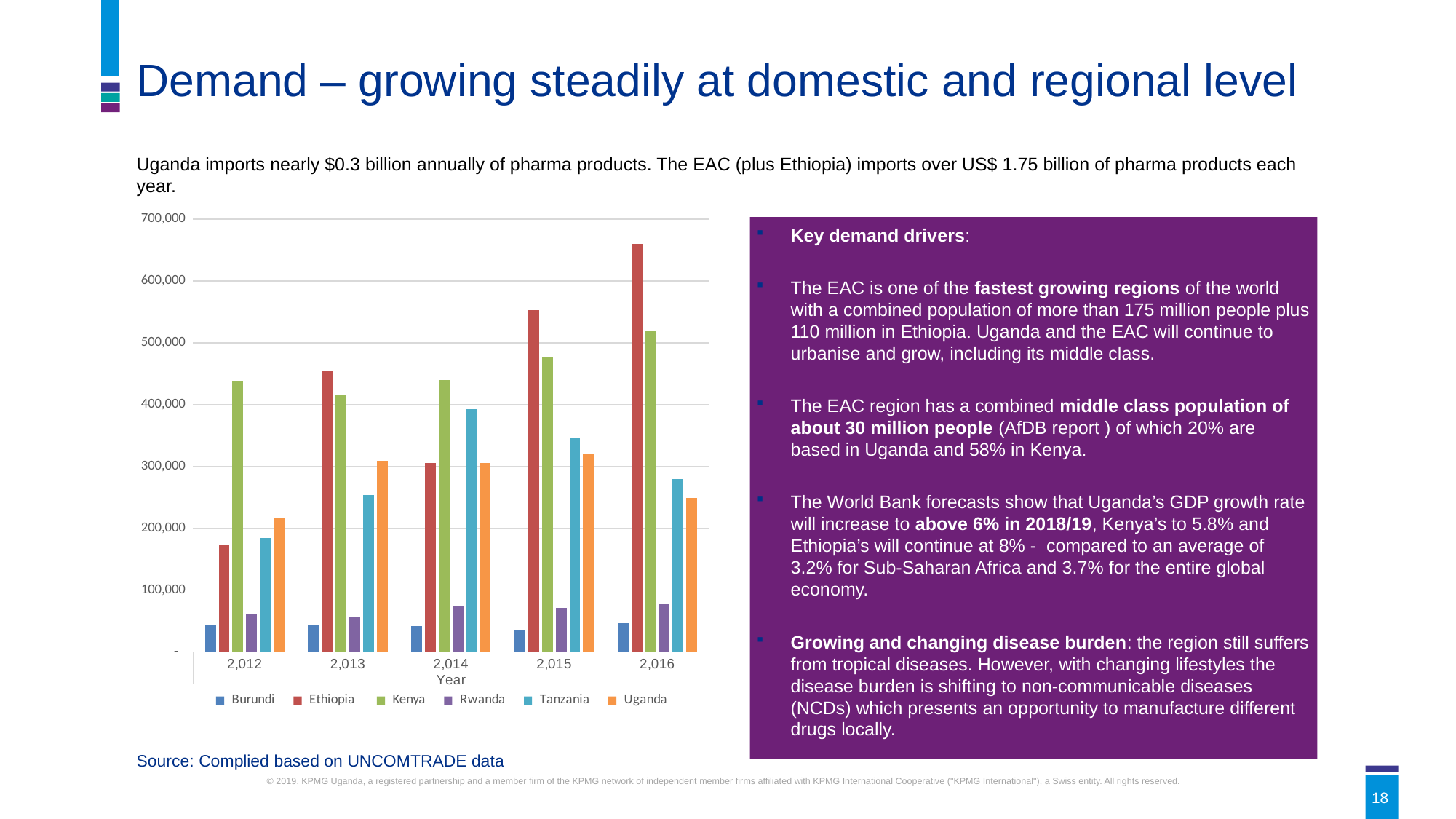
Is the value for Ethiopia in 2016 greater or less than 600,000? greater Which country has the lowest bar in 2016? Burundi How many series does the chart legend list? 6 Which country has the highest bar in 2016? Ethiopia What is the title of the x axis of the chart? Year Is the value for Ethiopia in 2015 greater or less than 500,000? greater Which country has the highest bar in 2012? Kenya Is the value for Burundi in 2012 greater or less than 100,000? less Does the value for Kenya rise or fall from 2014 to 2016? Rise How many years are shown on the x axis of the chart? 5 What kind of chart is shown on the slide? Bar chart In 2014, which is larger, the value for Tanzania or the value for Uganda? Tanzania